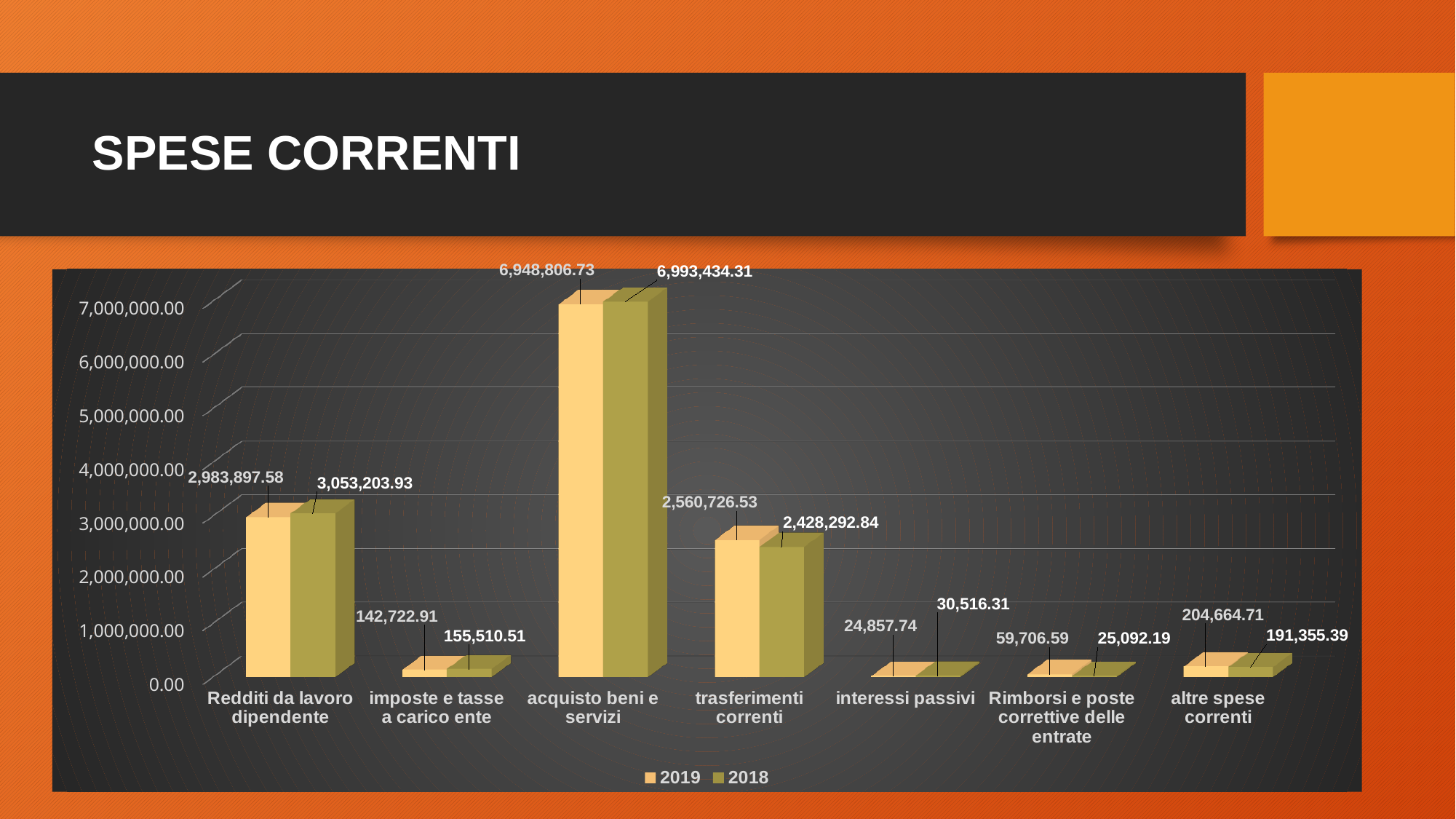
For Redditi da lavoro dipendente, which year has the larger value, 2019 or 2018? 2018 What is the 2019 value for interessi passivi? 24,857.74 What is the difference between the 2019 and 2018 values for Rimborsi e poste correttive delle entrate? 34,614.40 How many categories are shown on the x axis? 7 What is the 2018 value for Redditi da lavoro dipendente? 3,053,203.93 What is the title of the slide? SPESE CORRENTI What is the 2019 value for acquisto beni e servizi? 6,948,806.73 What is the 2018 value for altre spese correnti? 191,355.39 What is the difference between the 2019 and 2018 values for trasferimenti correnti? 132,433.69 How many series does the legend list? 2 Which category has the lowest 2019 value? interessi passivi Which category has the highest 2018 value? acquisto beni e servizi